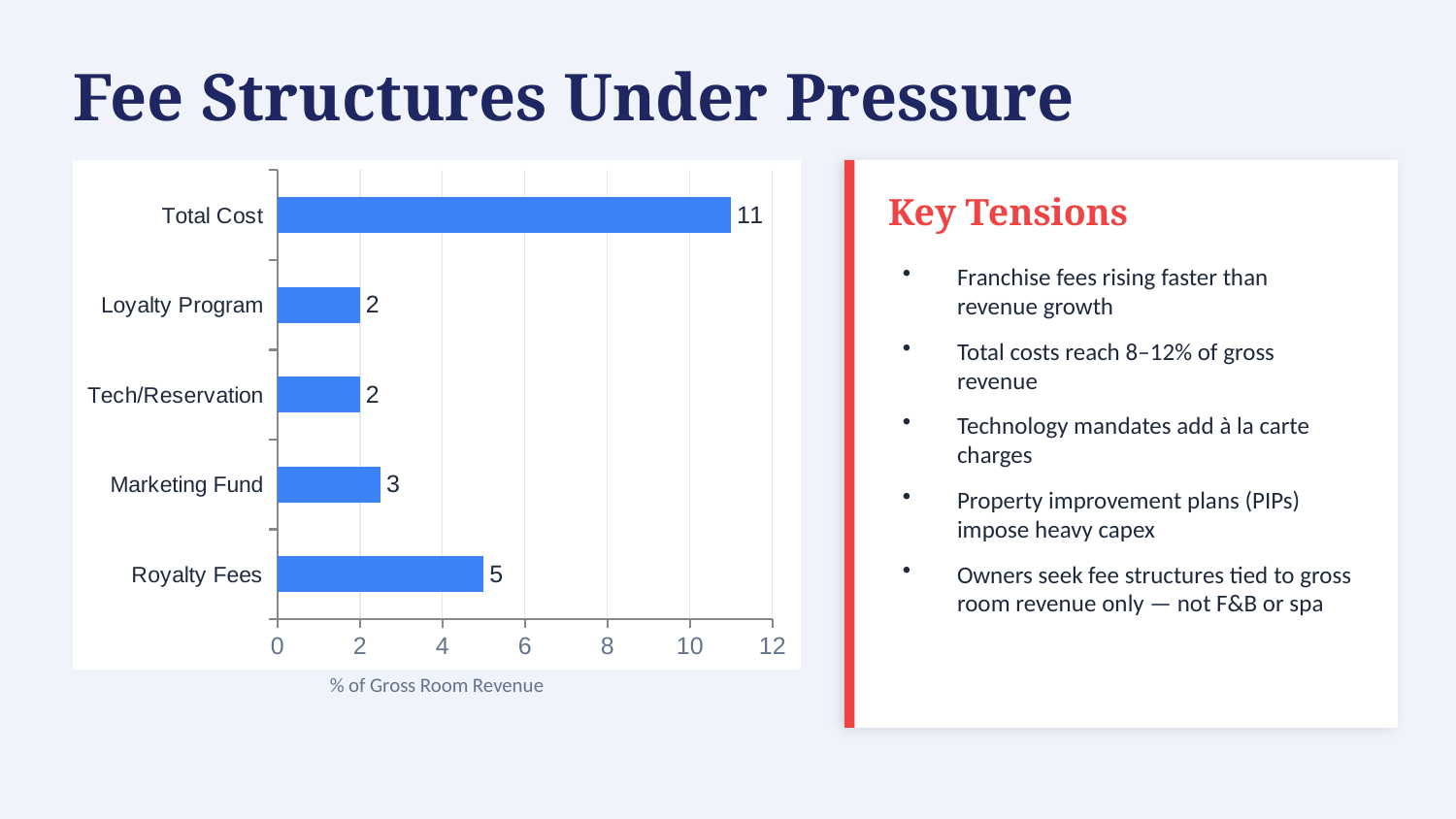
What is the difference between the values for Royalty Fees and Marketing Fund? 2 How many categories are shown in the chart? 5 What is the value for Marketing Fund? 3 Is the value for Total Cost greater or less than 10? greater What is the value for Loyalty Program? 2 What is the difference between the values for Total Cost and Royalty Fees? 6 What kind of chart is shown on the slide? bar chart Which category has the highest value? Total Cost What is the value for Total Cost? 11 What is the value for Royalty Fees? 5 What is the label on the horizontal axis of the chart? % of Gross Room Revenue Which is larger, the value for Marketing Fund or the value for Tech/Reservation? Marketing Fund